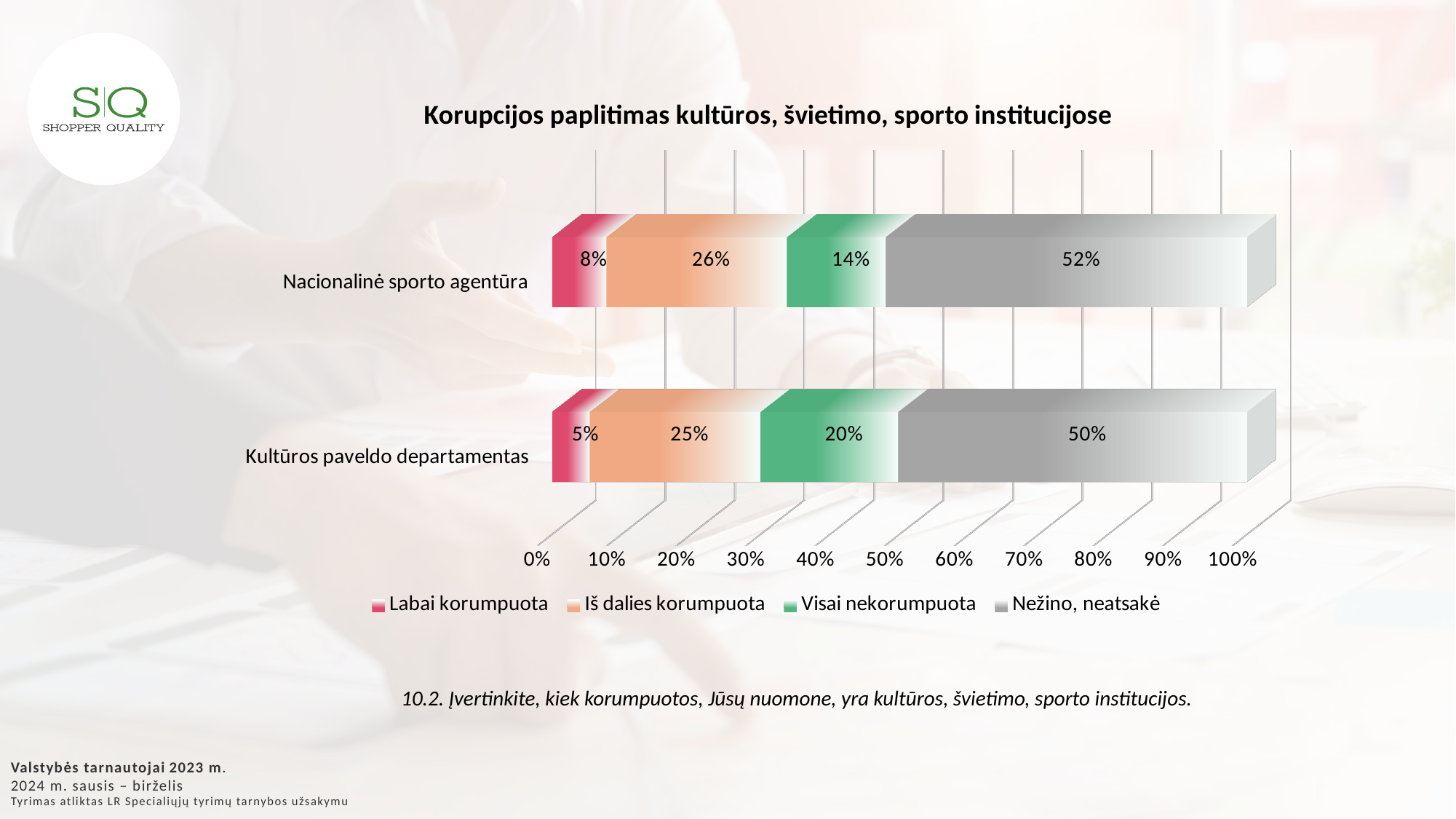
What is the title of the chart? Korupcijos paplitimas kultūros, švietimo, sporto institucijose How many categories are shown on the chart? 2 What is the value for "Nežino, neatsakė" for Kultūros paveldo departamentas? 50% What is the difference between the "Nežino, neatsakė" values for Nacionalinė sporto agentūra and Kultūros paveldo departamentas? 2% Which category has the lower value for "Labai korumpuota"? Kultūros paveldo departamentas What is the value for "Iš dalies korumpuota" for Nacionalinė sporto agentūra? 26% What is the value for "Labai korumpuota" for Nacionalinė sporto agentūra? 8% Which category has the higher value for "Visai nekorumpuota"? Kultūros paveldo departamentas How many series does the legend list? 4 What is the value for "Visai nekorumpuota" for Kultūros paveldo departamentas? 20% Is the "Visai nekorumpuota" value larger for Nacionalinė sporto agentūra or for Kultūros paveldo departamentas? Kultūros paveldo departamentas What kind of chart is shown on the slide? Stacked bar chart